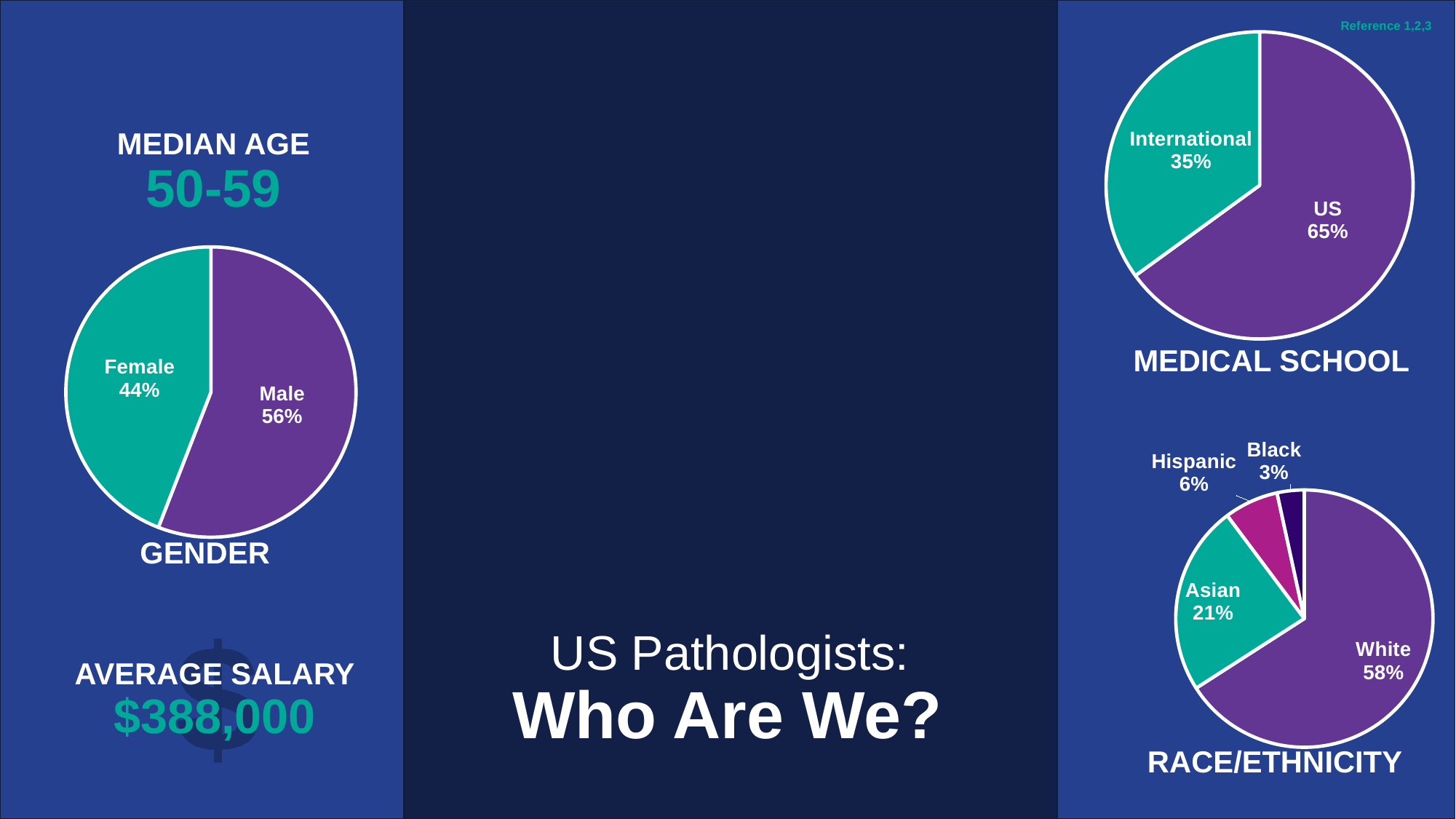
In the RACE/ETHNICITY pie chart, which category has the largest share? White In the GENDER pie chart, which slice is larger, Male or Female? Male In the RACE/ETHNICITY pie chart, what percentage is Asian? 21% In the MEDICAL SCHOOL pie chart, how many slices are there? 2 In the MEDICAL SCHOOL pie chart, what percentage is International? 35% In the RACE/ETHNICITY pie chart, what is the difference between the Hispanic and Black shares? 3% In the RACE/ETHNICITY pie chart, how many categories are shown? 4 In the GENDER pie chart, what is the difference between the Male and Female shares? 12% In the MEDICAL SCHOOL pie chart, which category has the largest share? US What type of chart is used for the GENDER data? Pie chart In the RACE/ETHNICITY pie chart, which category has the smallest share? Black In the GENDER pie chart, what percentage is Female? 44%